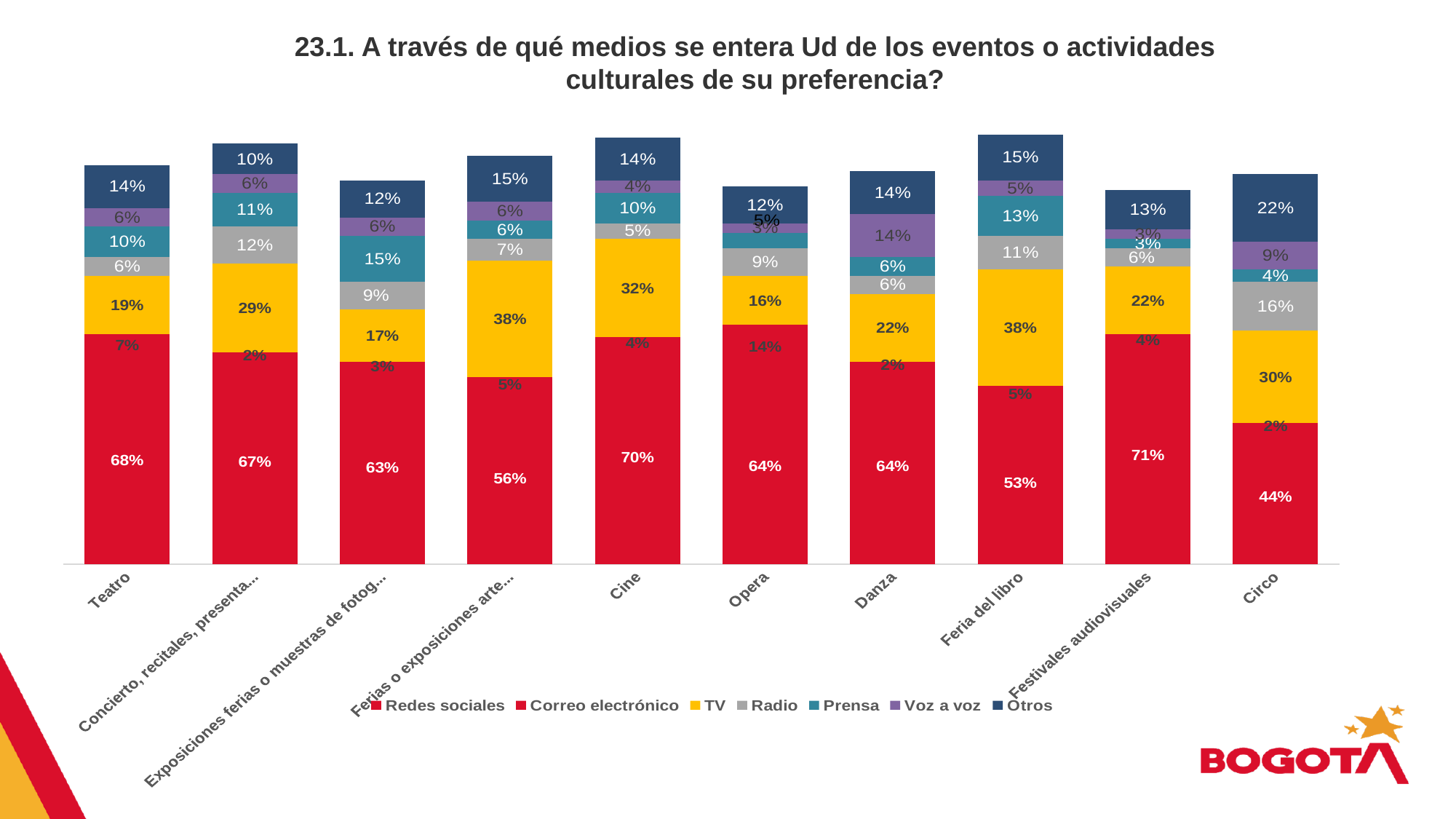
What is the difference between the Redes sociales values for Teatro and Circo? 24% Which is larger, the TV value for Cine or the TV value for Danza? Cine How many series does the legend list? 7 Which category has the highest Redes sociales value? Festivales audiovisuales Which category has the lowest Redes sociales value? Circo What type of chart is shown on the slide? Stacked bar chart What is the total of the stacked bar for Teatro? 130% What is the Correo electrónico value for Opera? 14% How many categories are shown along the x axis? 10 What is the Redes sociales value for Cine? 70% What is the TV value for Feria del libro? 38% What is the Otros value for Circo? 22%